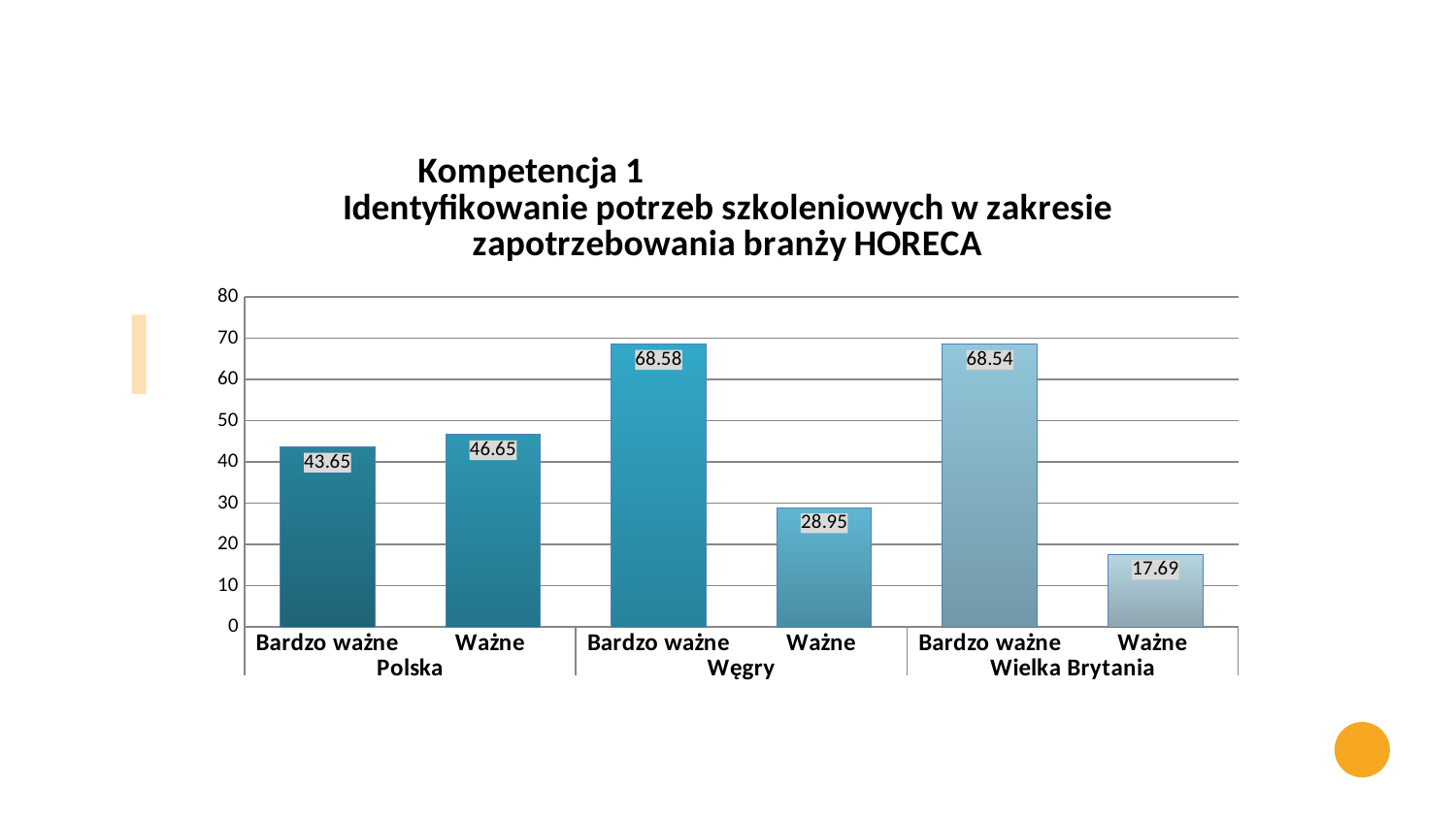
How many bars are plotted on the chart? 6 How many countries are shown on the x axis? 3 Is the value for "Ważne" in Wielka Brytania greater or less than 20? less What is the value for "Bardzo ważne" in Polska? 43.65 What is the value for "Ważne" in Węgry? 28.95 What is the difference between "Bardzo ważne" and "Ważne" for Wielka Brytania? 50.85 What kind of chart is shown on the slide? bar chart What is the difference between "Bardzo ważne" and "Ważne" for Węgry? 39.63 What is the value for "Ważne" in Wielka Brytania? 17.69 Which bar has the lowest value on the chart? Ważne, Wielka Brytania What is the value for "Bardzo ważne" in Wielka Brytania? 68.54 Which is larger: "Ważne" for Węgry or "Ważne" for Wielka Brytania? Ważne for Węgry